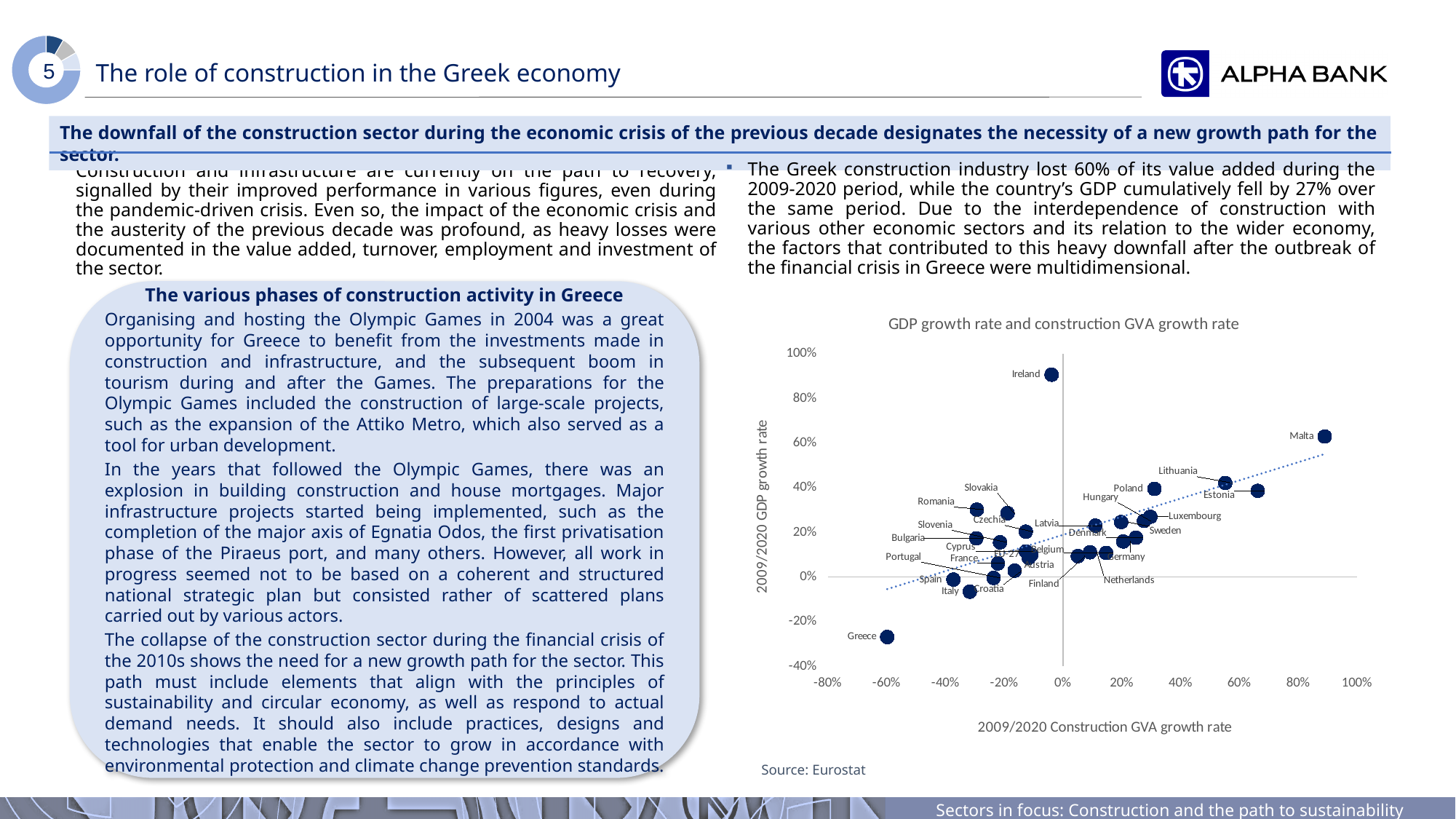
Is the 2009/2020 GDP growth rate for Greece greater or less than -20%? less What kind of chart is shown on the slide? Scatter chart Is the 2009/2020 GDP growth rate for Ireland greater or less than 80%? greater What is the label of the horizontal axis of the chart? 2009/2020 Construction GVA growth rate Which country has the lowest 2009/2020 GDP growth rate in the chart? Greece Which country has a higher 2009/2020 GDP growth rate, Ireland or Malta? Ireland Do the GDP growth rates generally rise or fall as the construction GVA growth rate increases along the x axis? rise Is the 2009/2020 construction GVA growth rate for Malta greater or less than 80%? greater What is the title of the chart on the slide? GDP growth rate and construction GVA growth rate Which country has the highest 2009/2020 GDP growth rate in the chart? Ireland Which country has the lowest 2009/2020 construction GVA growth rate in the chart? Greece Which country has the highest 2009/2020 construction GVA growth rate in the chart? Malta